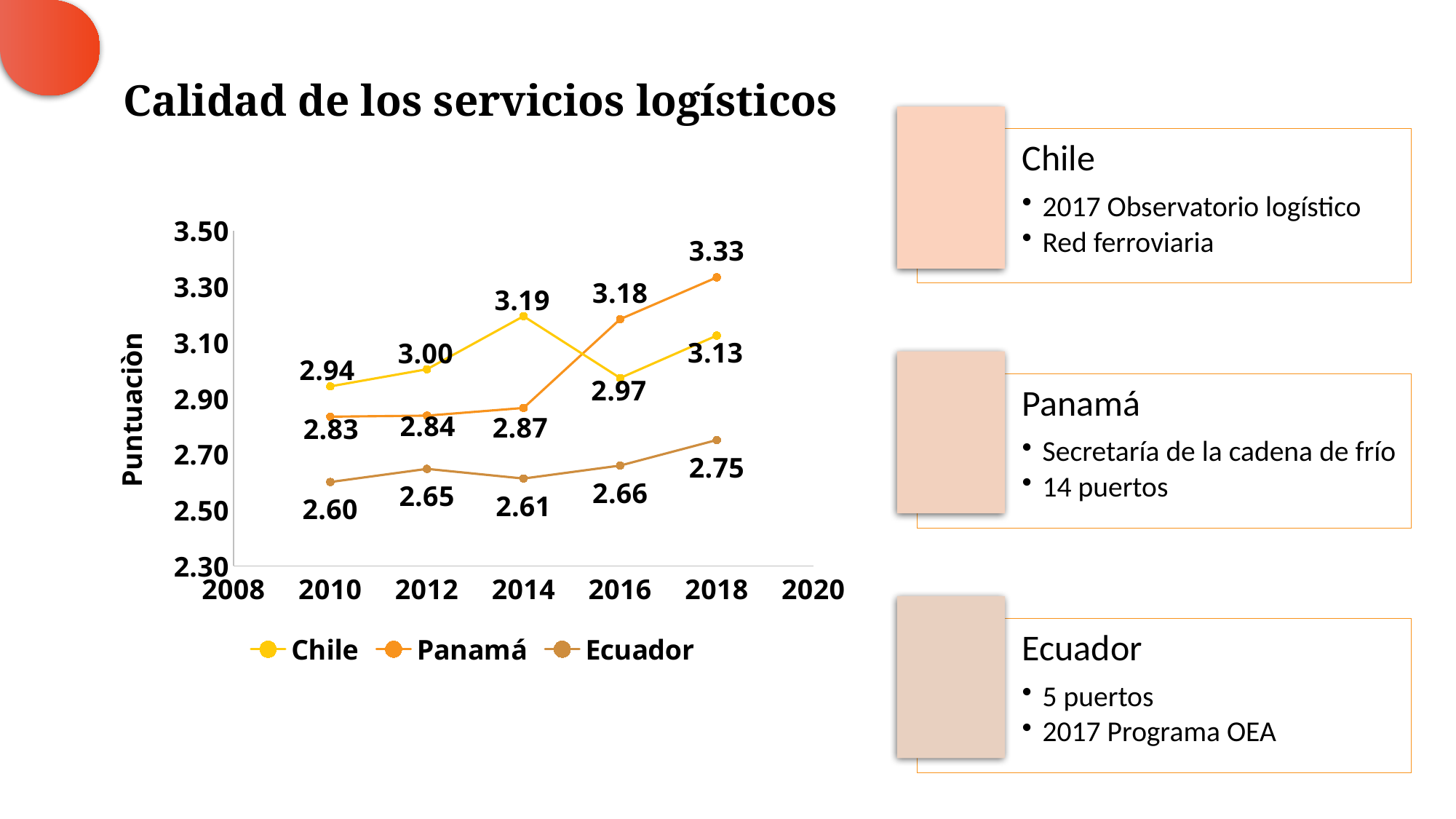
Which is larger in 2016, the value for Chile or the value for Panamá? Panamá What is the value for Chile in 2014? 3.19 What is the label of the vertical axis? Puntuación What is the value for Ecuador in 2010? 2.60 What is the value for Panamá in 2018? 3.33 How many data points are plotted for each series? 5 What is the difference between Panamá and Chile in 2018? 0.20 Do the values for Ecuador rise or fall from 2016 to 2018? Rise In which year does Ecuador have its lowest value? 2010 In which year does Panamá reach its highest value? 2018 How many series does the legend list? 3 What kind of chart is shown on the slide? Line chart